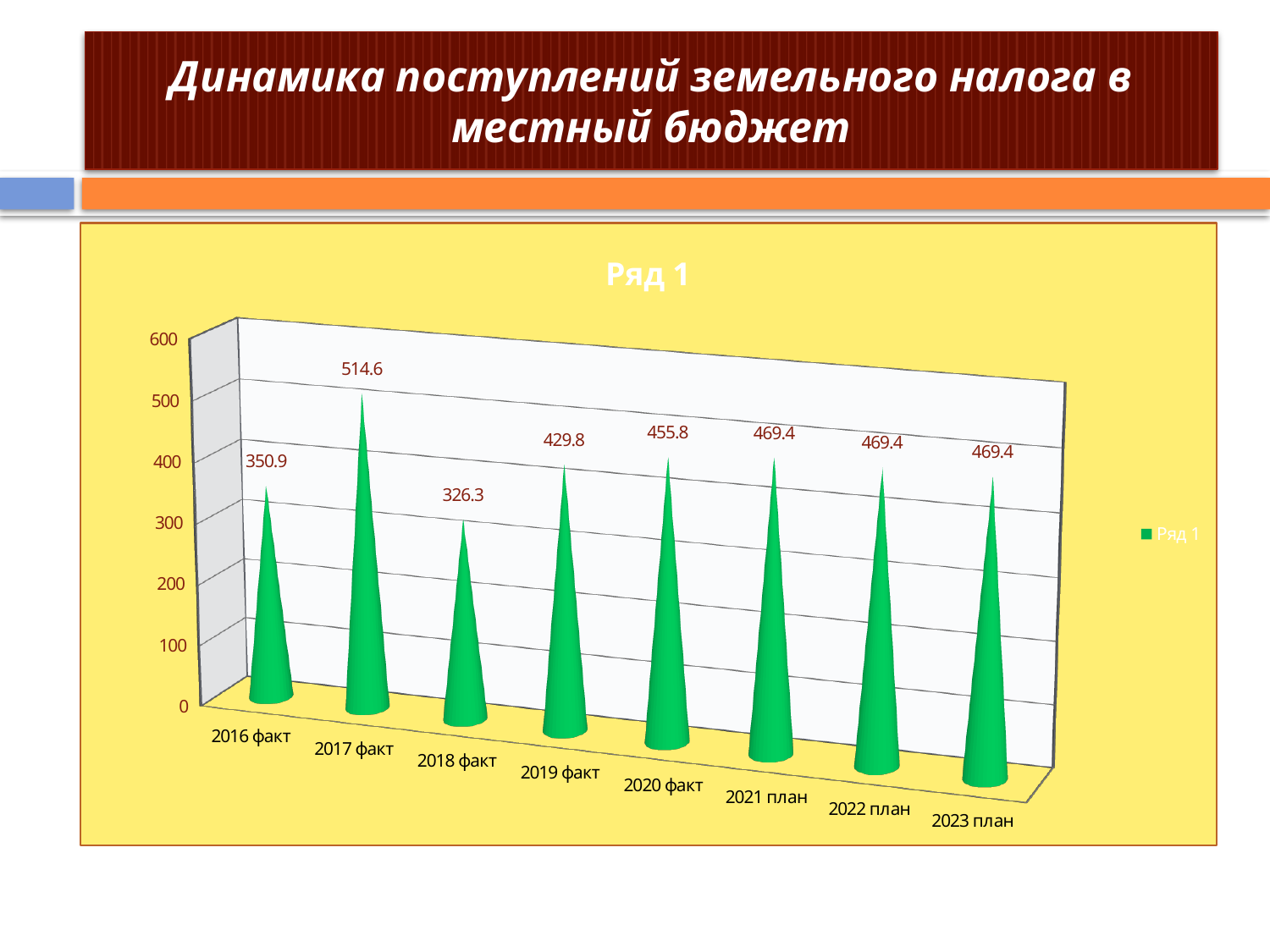
How many series does the legend list? 1 What is the difference between the values for 2017 факт and 2016 факт? 163.7 Which is larger, the value for 2019 факт or the value for 2020 факт? 2020 факт What is the value for 2018 факт? 326.3 Which category has the lowest value? 2018 факт Which category has the highest value? 2017 факт What is the title of the chart? Ряд 1 What kind of chart is shown on the slide? bar chart What is the value for 2017 факт? 514.6 What is the value for 2020 факт? 455.8 What is the value for 2023 план? 469.4 How many categories are shown on the x axis? 8